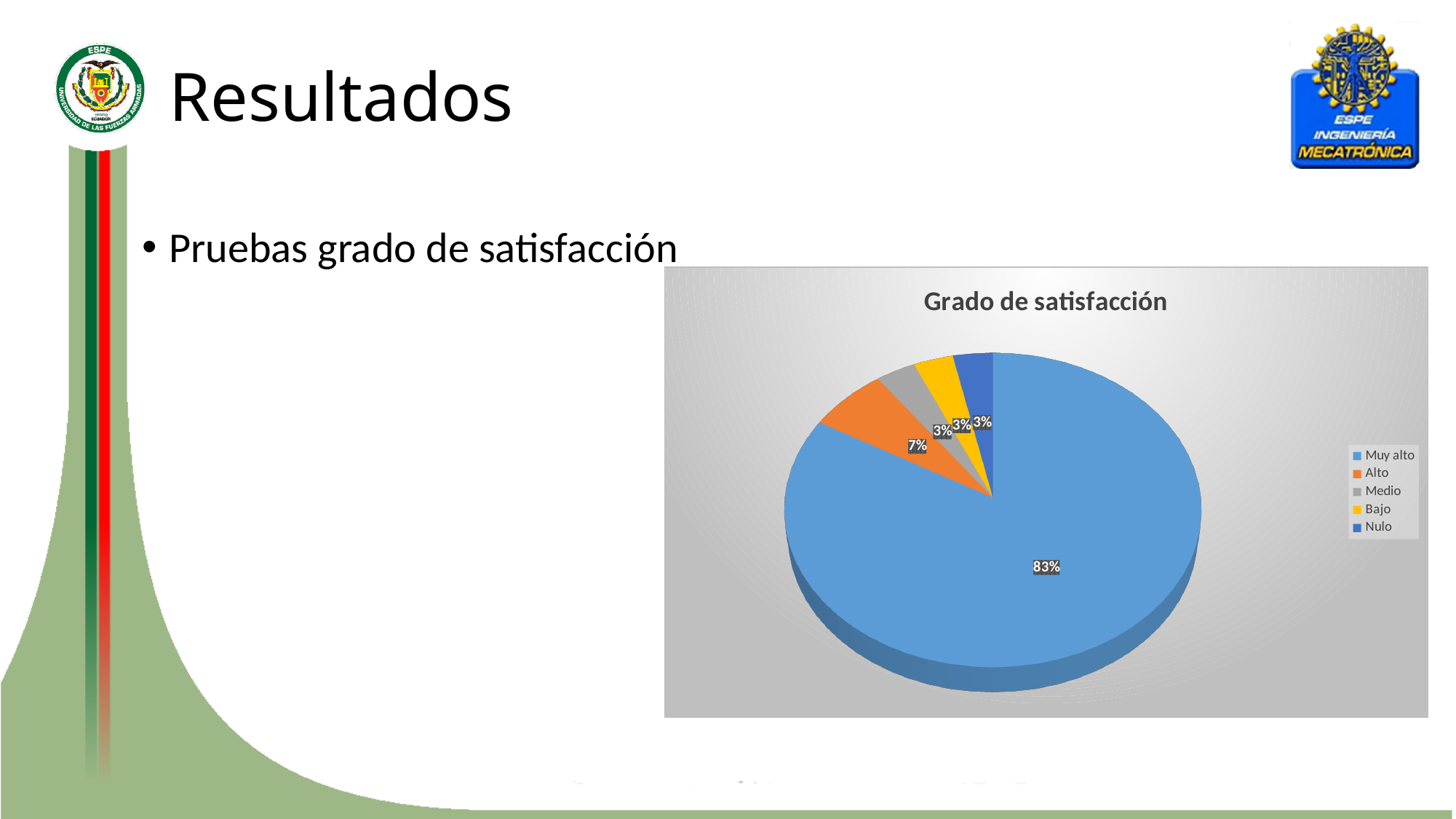
What is the combined share of "Medio", "Bajo" and "Nulo"? 9% What share of the pie does "Alto" have? 7% What is the difference between the "Muy alto" and "Alto" shares? 76% What share of the pie does "Muy alto" have? 83% What is the title of the chart? Grado de satisfacción Which category has the largest slice of the pie? Muy alto What kind of chart is shown on the slide? pie chart What share of the pie does "Medio" have? 3% Which is larger, the share for "Alto" or the share for "Bajo"? Alto How many categories does the legend list? 5 Which colour represents "Bajo" in the legend? yellow